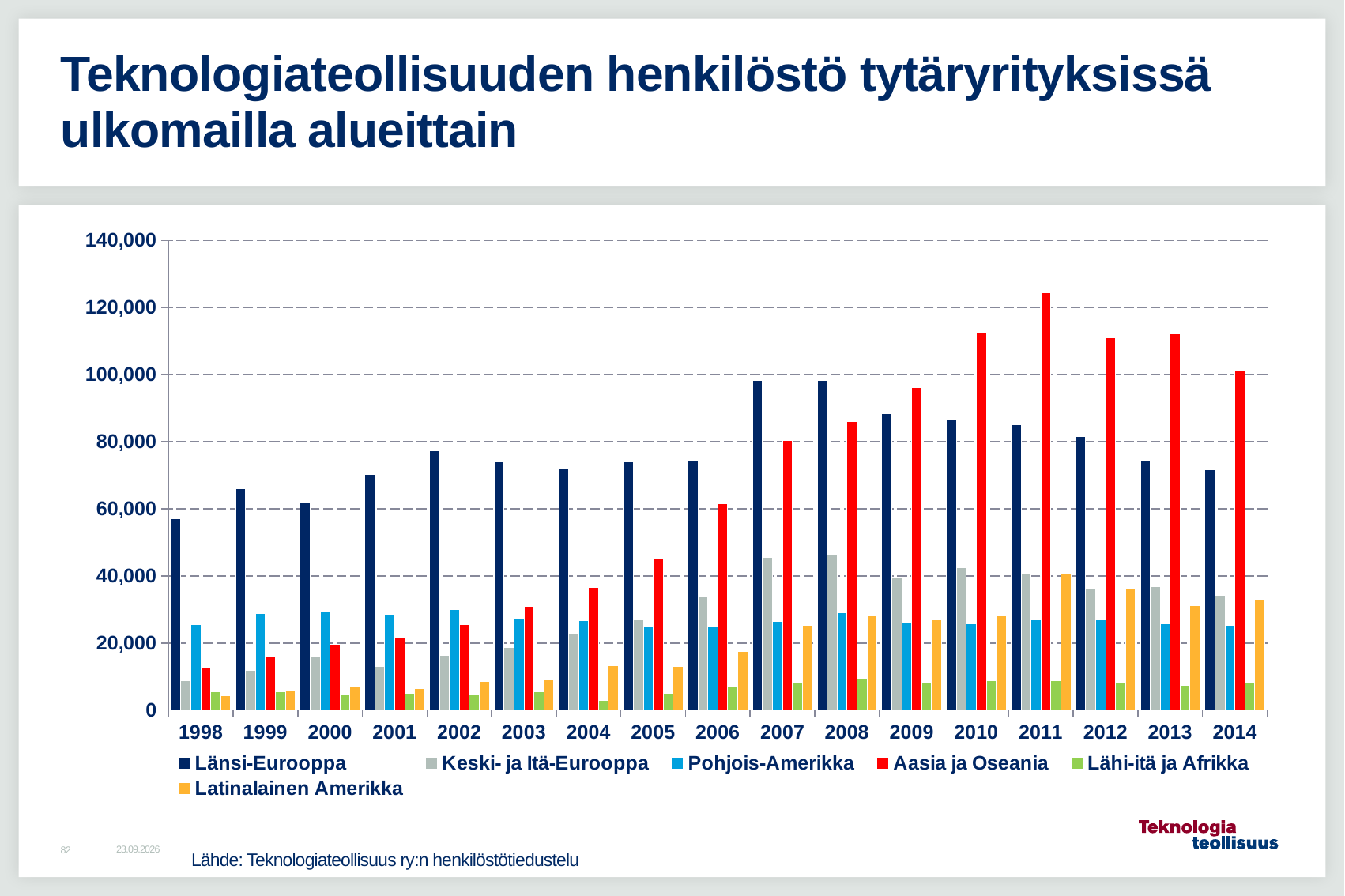
Which series has the lowest value in 2014? Lähi-itä ja Afrikka How many series does the legend list? 6 Is the value for Länsi-Eurooppa in 2007 greater or less than 80,000? greater How many years are shown on the x axis? 17 Is the value for Aasia ja Oseania in 2011 greater or less than 120,000? greater What colour represents Aasia ja Oseania in the chart? red What kind of chart is shown on the slide? bar chart Is the value for Länsi-Eurooppa in 1998 greater or less than 60,000? less In 2006, which is larger: Länsi-Eurooppa or Aasia ja Oseania? Länsi-Eurooppa In which year is the value for Aasia ja Oseania highest? 2011 In 2014, which is larger: Aasia ja Oseania or Länsi-Eurooppa? Aasia ja Oseania Do the values for Aasia ja Oseania rise or fall from 1998 to 2011? rise